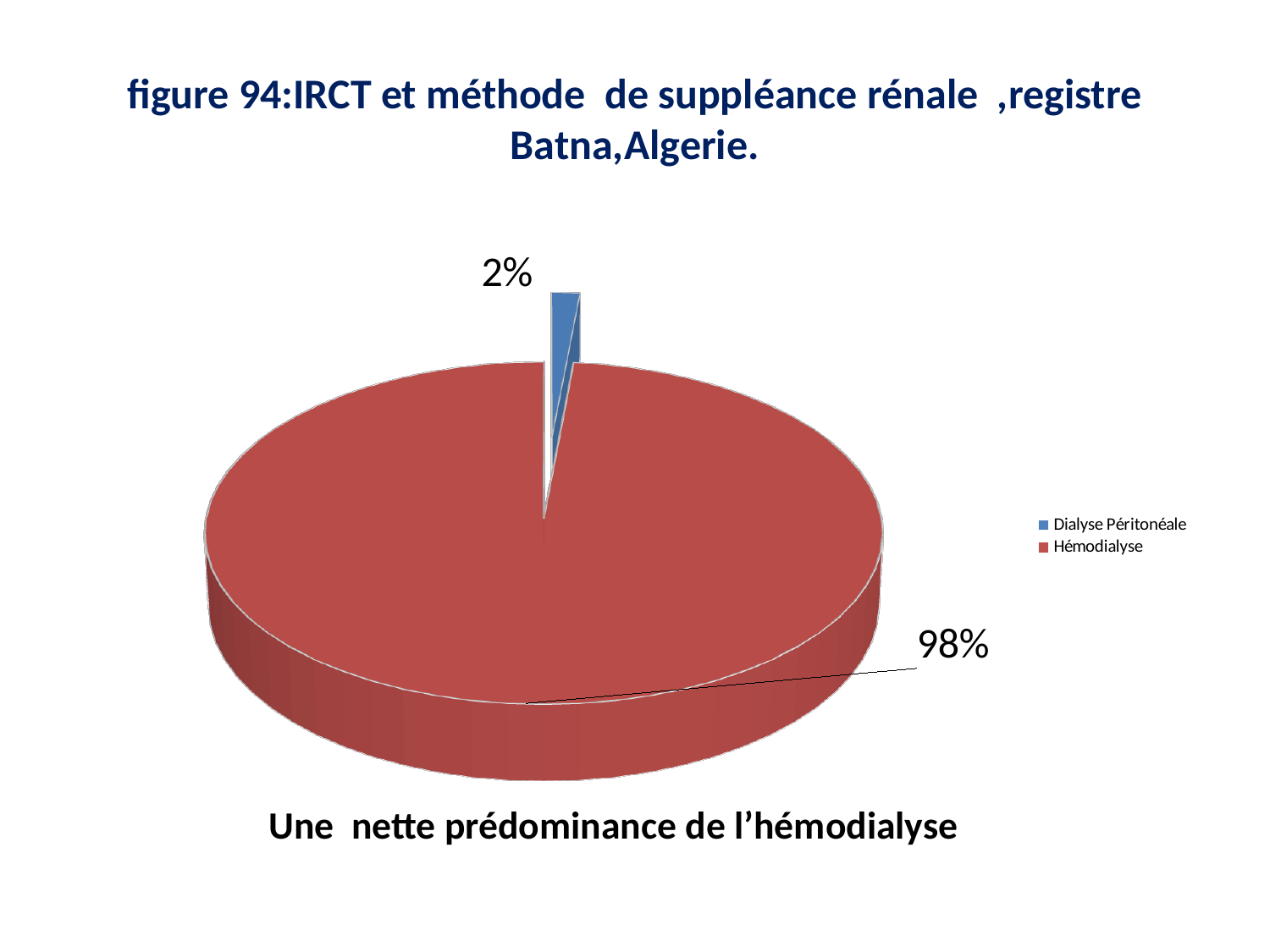
What is the title of the chart? figure 94:IRCT et méthode de suppléance rénale ,registre Batna,Algerie. What is the difference in percentage points between Hémodialyse and Dialyse Péritonéale? 96 How many categories does the pie chart show? 2 What share of the pie does Dialyse Péritonéale represent? 2% What share of the pie does Hémodialyse represent? 98% Which category has the smallest slice of the pie? Dialyse Péritonéale What colour is the Dialyse Péritonéale slice? blue Which is larger, the share for Hémodialyse or the share for Dialyse Péritonéale? Hémodialyse What kind of chart is shown on the slide? pie chart Which category has the largest slice of the pie? Hémodialyse How many entries does the legend list? 2